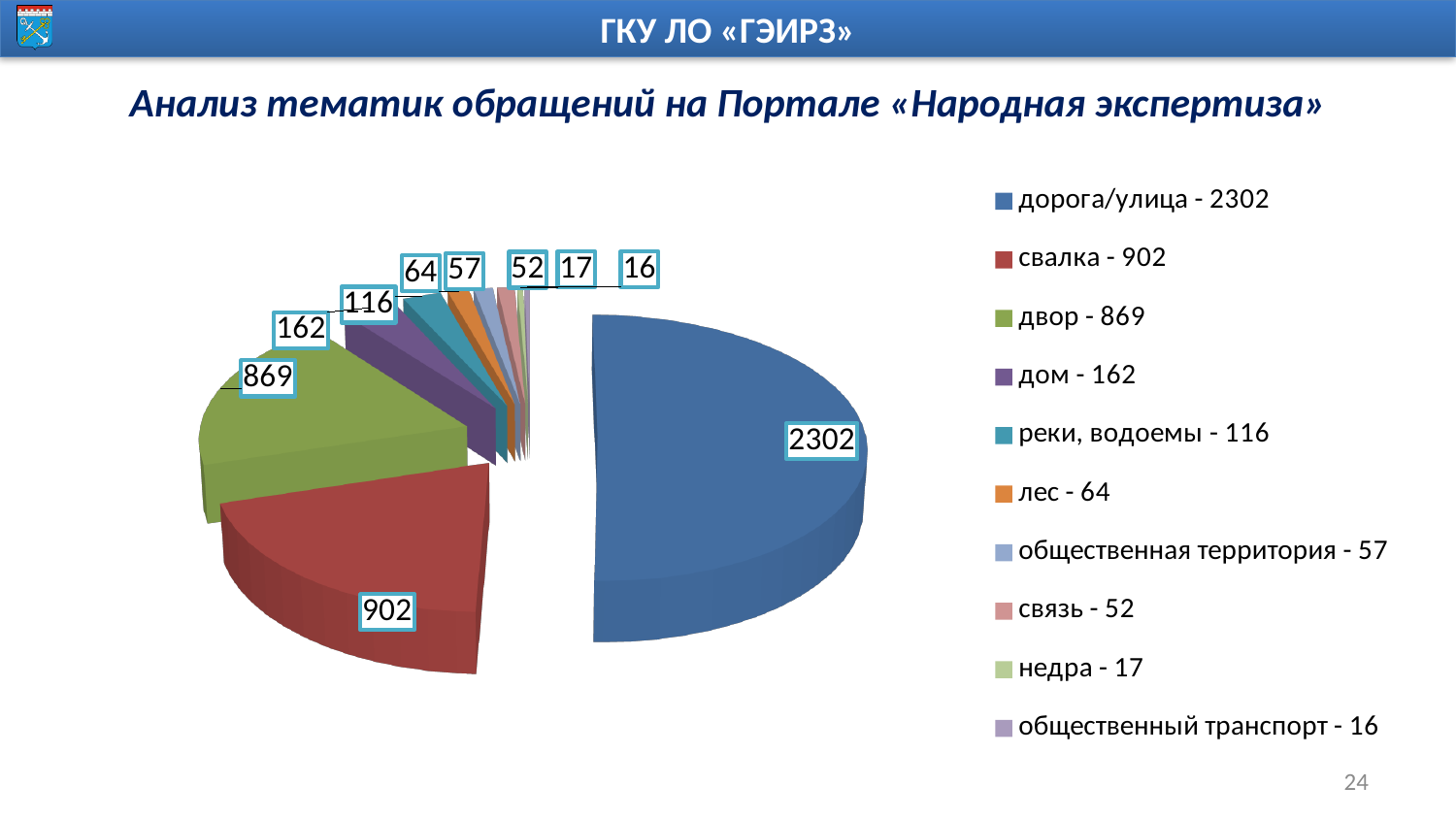
What is the value for общественная территория? 57 What is the title of the slide containing the chart? Анализ тематик обращений на Портале «Народная экспертиза» Which is larger, the value for лес or the value for связь? лес Which category has the highest value? дорога/улица What is the value for свалка? 902 What type of chart is shown on the slide? pie chart What is the value for реки, водоемы? 116 What is the difference between the values for двор and дом? 707 How many categories does the pie chart show? 10 What is the value for дорога/улица? 2302 Which category has the lowest value? общественный транспорт What is the difference between the values for дорога/улица and свалка? 1400